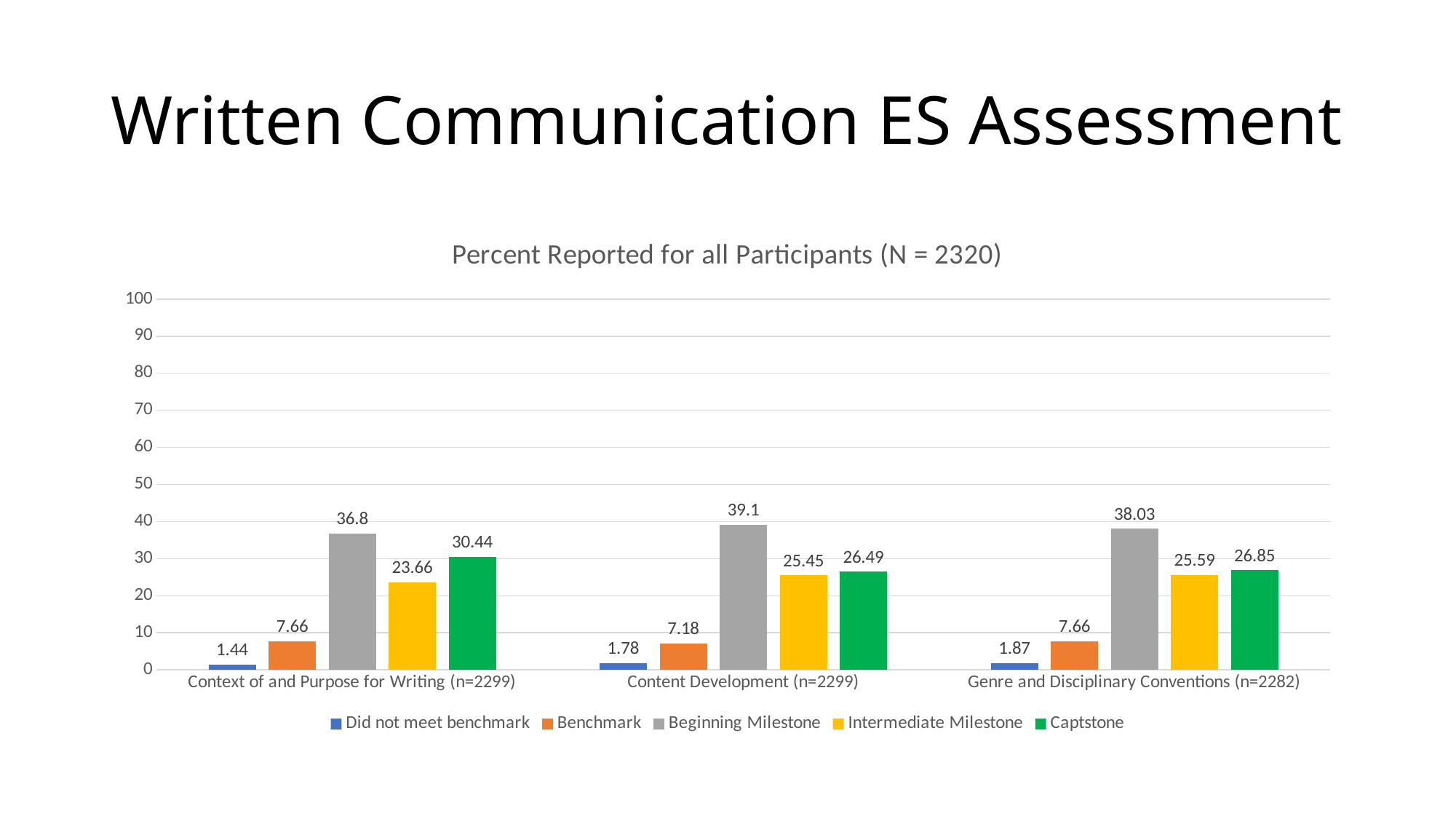
How many series does the legend list? 5 What is the difference between the Beginning Milestone and Intermediate Milestone values in the Context of and Purpose for Writing (n=2299) category? 13.14 Which series has the highest value in the Genre and Disciplinary Conventions (n=2282) category? Beginning Milestone Is the Beginning Milestone value for Context of and Purpose for Writing (n=2299) greater or less than 40? less What is the title of the chart? Percent Reported for all Participants (N = 2320) What is the value for Did not meet benchmark in the Genre and Disciplinary Conventions (n=2282) category? 1.87 How many categories are shown on the x axis? 3 Which series has the lowest value in the Content Development (n=2299) category? Did not meet benchmark What is the value for Beginning Milestone in the Content Development (n=2299) category? 39.1 What is the value for Captstone in the Context of and Purpose for Writing (n=2299) category? 30.44 Which is larger: the Captstone value for Content Development (n=2299) or the Captstone value for Genre and Disciplinary Conventions (n=2282)? Genre and Disciplinary Conventions (n=2282) What kind of chart is shown on the slide? bar chart